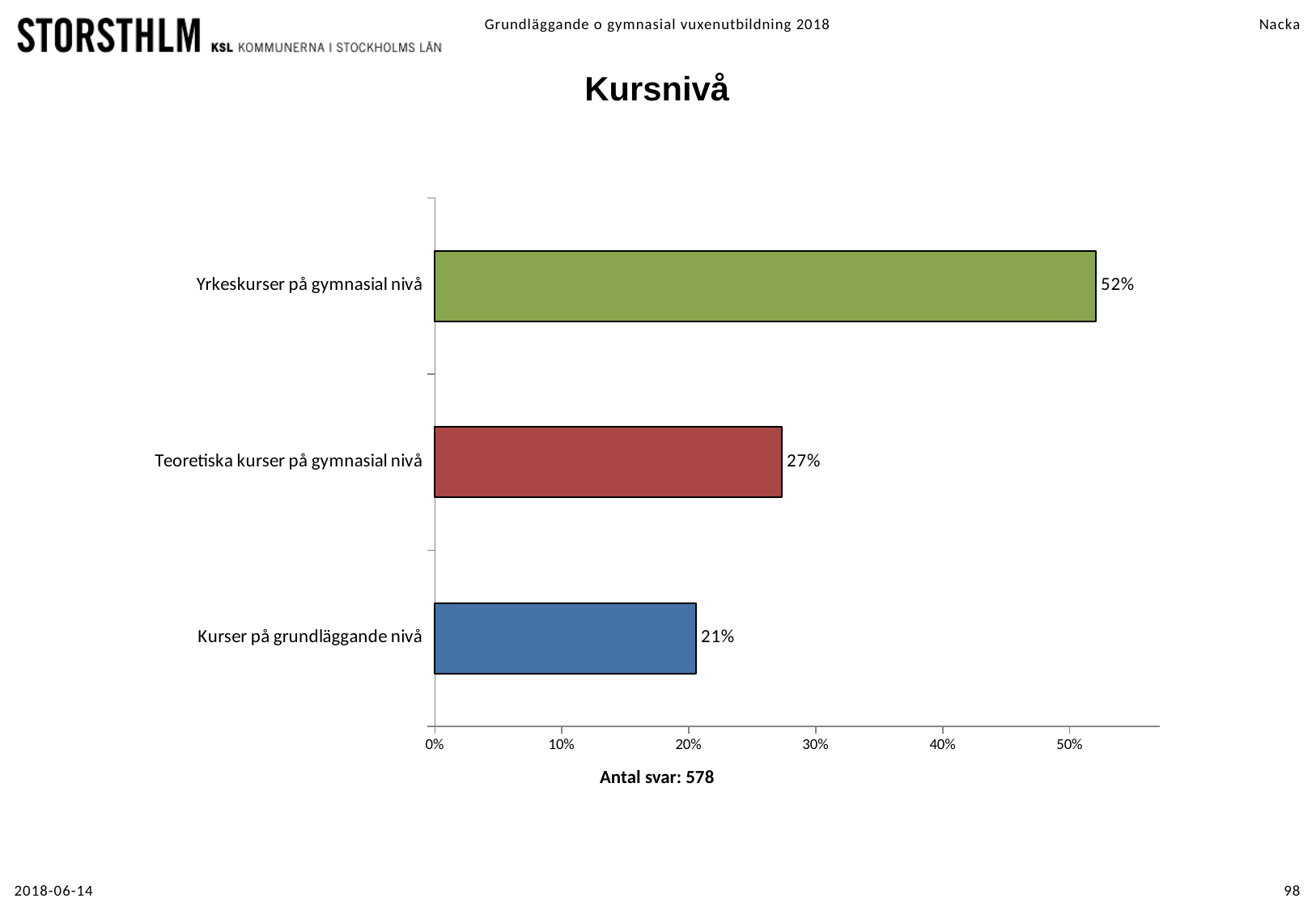
What is the value for Teoretiska kurser på gymnasial nivå? 27% How many categories are shown in the chart? 3 What is the value for Kurser på grundläggande nivå? 21% What is the value for Yrkeskurser på gymnasial nivå? 52% Which is larger, the value for Teoretiska kurser på gymnasial nivå or Kurser på grundläggande nivå? Teoretiska kurser på gymnasial nivå What is the difference between the values for Teoretiska kurser på gymnasial nivå and Kurser på grundläggande nivå? 6% What is the title of the chart? Kursnivå What is the difference between the values for Yrkeskurser på gymnasial nivå and Teoretiska kurser på gymnasial nivå? 25% Is the value for Yrkeskurser på gymnasial nivå greater or less than 50%? greater Which category has the highest value? Yrkeskurser på gymnasial nivå Which category has the lowest value? Kurser på grundläggande nivå What kind of chart is shown on the slide? bar chart